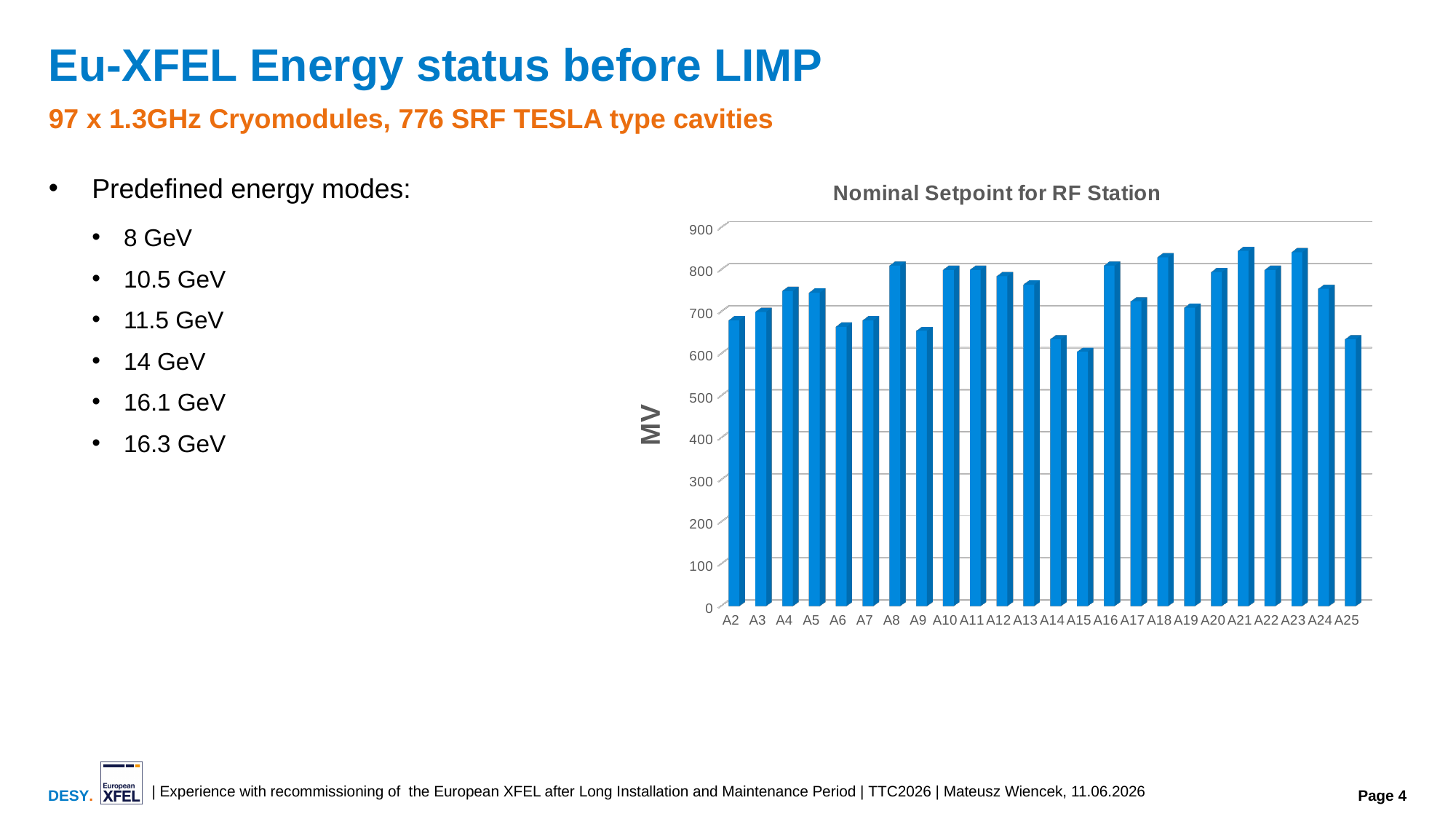
Is the value for A21 greater or less than 800? greater What is the title of the chart? Nominal Setpoint for RF Station Is the value for A14 greater or less than 700? less Which has the larger nominal setpoint, A8 or A9? A8 What is the label on the vertical axis of the chart? MV What kind of chart is shown on the slide? bar chart Which RF station has the lowest nominal setpoint? A15 Is the value for A15 greater or less than 700? less Which has the larger nominal setpoint, A15 or A16? A16 How many RF stations (categories) are plotted on the x axis? 24